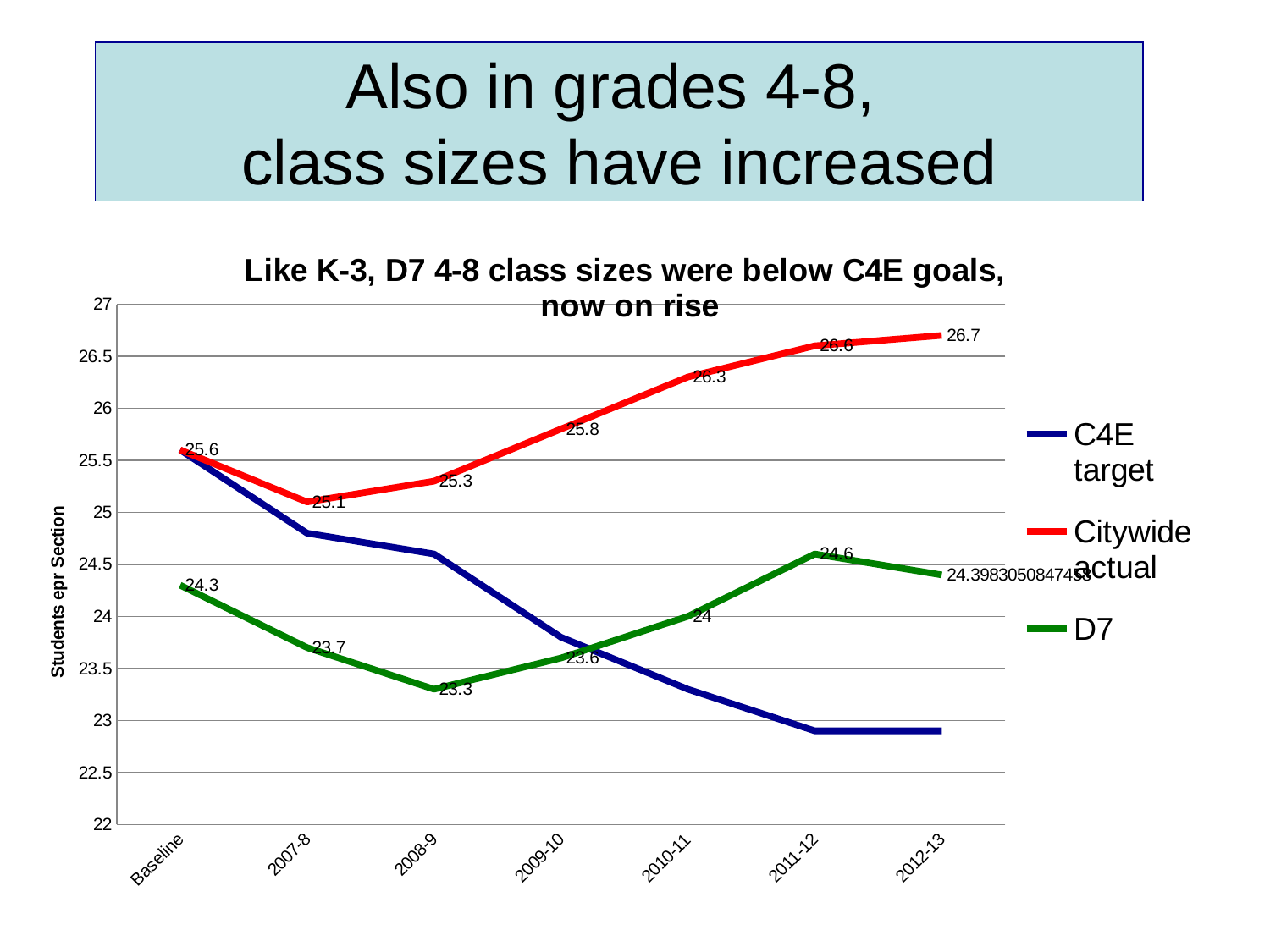
Is the C4E target value for 2011-12 greater or less than 23.5? less In which year is the Citywide actual value highest? 2012-13 In 2010-11, which is larger: Citywide actual or D7? Citywide actual How many series does the legend list? 3 What kind of chart is shown on the slide? line chart Does the C4E target series rise or fall from Baseline to 2012-13? fall How many points are plotted along the x axis for each series? 7 What colour is the D7 line in the legend? green In which year is the D7 value lowest? 2008-9 What is the D7 value for 2008-9? 23.3 What is the Citywide actual value for 2012-13? 26.7 By how much did the Citywide actual value increase from Baseline to 2012-13? 1.1